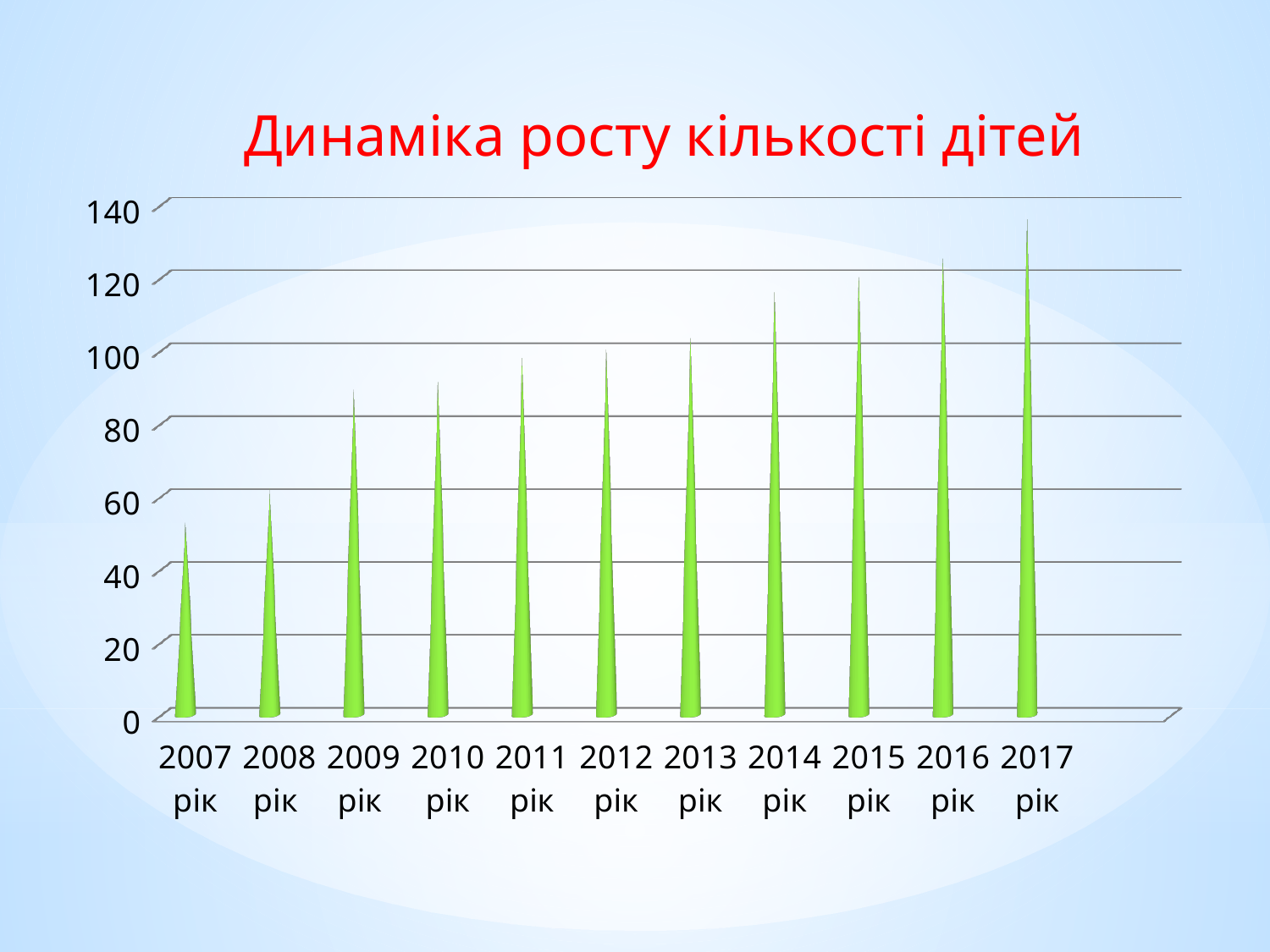
Do the values rise or fall from 2007 to 2017 along the x axis? rise Is the value for 2017 рік greater or less than 120? greater Which year has the lowest value in the chart? 2007 рік Which year has the highest value in the chart? 2017 рік What is the title of the chart? Динаміка росту кількості дітей Is the value for 2010 рік greater or less than 100? less What kind of chart is shown on the slide? bar chart Which is larger, the value for 2009 рік or the value for 2014 рік? 2014 рік Is the value for 2016 рік greater or less than 140? less How many years are shown on the x axis of the chart? 11